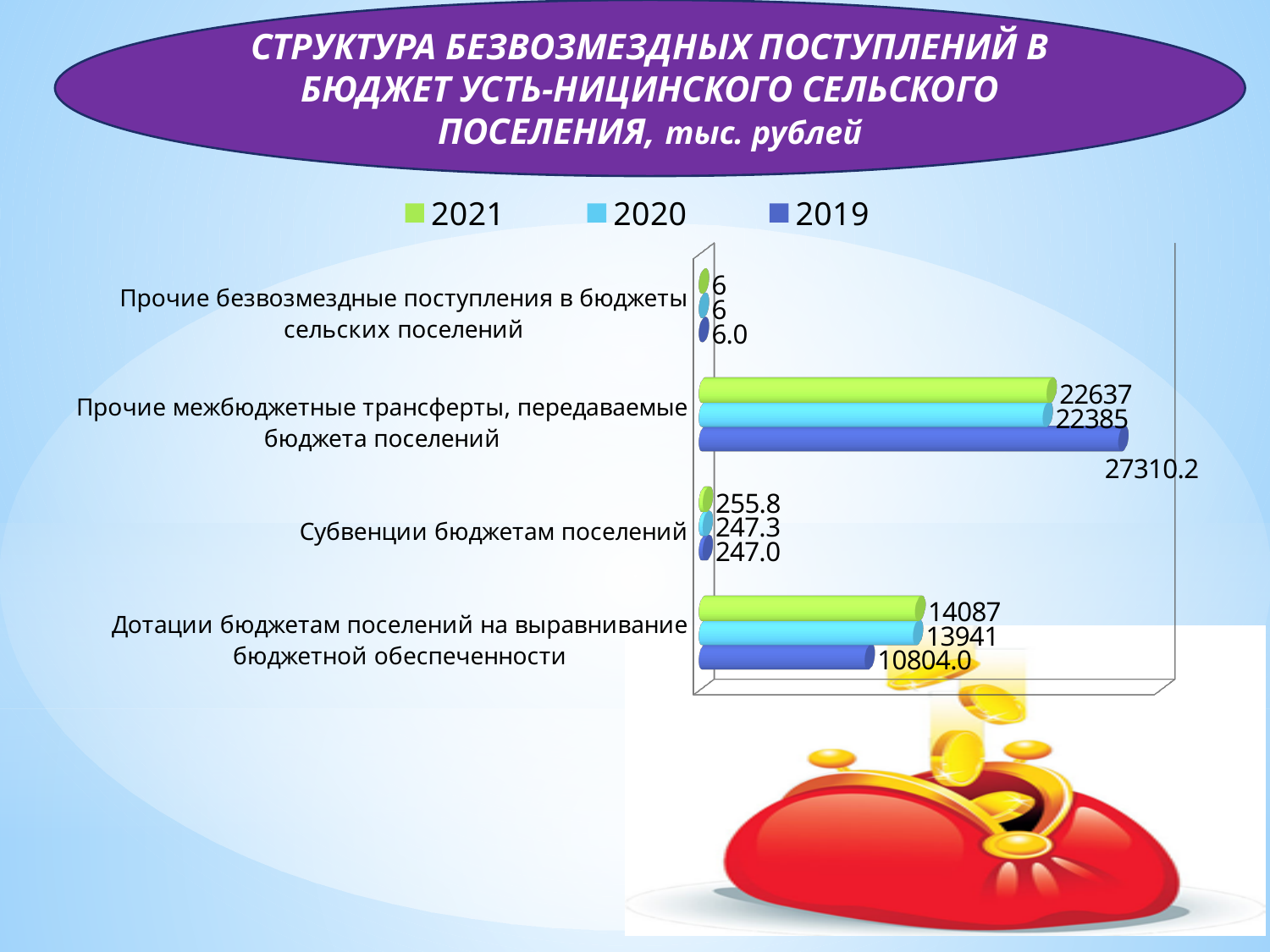
For Прочие межбюджетные трансферты, передаваемые бюджета поселений, which year has the larger value: 2019 or 2021? 2019 What is the 2020 value for Субвенции бюджетам поселений? 247.3 What is the 2019 value for Прочие безвозмездные поступления в бюджеты сельских поселений? 6.0 Which category has the highest 2019 value? Прочие межбюджетные трансферты, передаваемые бюджета поселений What is the 2021 value for Прочие межбюджетные трансферты, передаваемые бюджета поселений? 22637 What is the 2019 value for Дотации бюджетам поселений на выравнивание бюджетной обеспеченности? 10804.0 Which category has the lowest 2021 value? Прочие безвозмездные поступления в бюджеты сельских поселений What kind of chart is shown on the slide? Bar chart How many series does the legend list? 3 Which colour represents the 2020 series in the legend? Light blue How many categories are shown on the chart? 4 What is the difference between the 2021 and 2020 values for Дотации бюджетам поселений на выравнивание бюджетной обеспеченности? 146